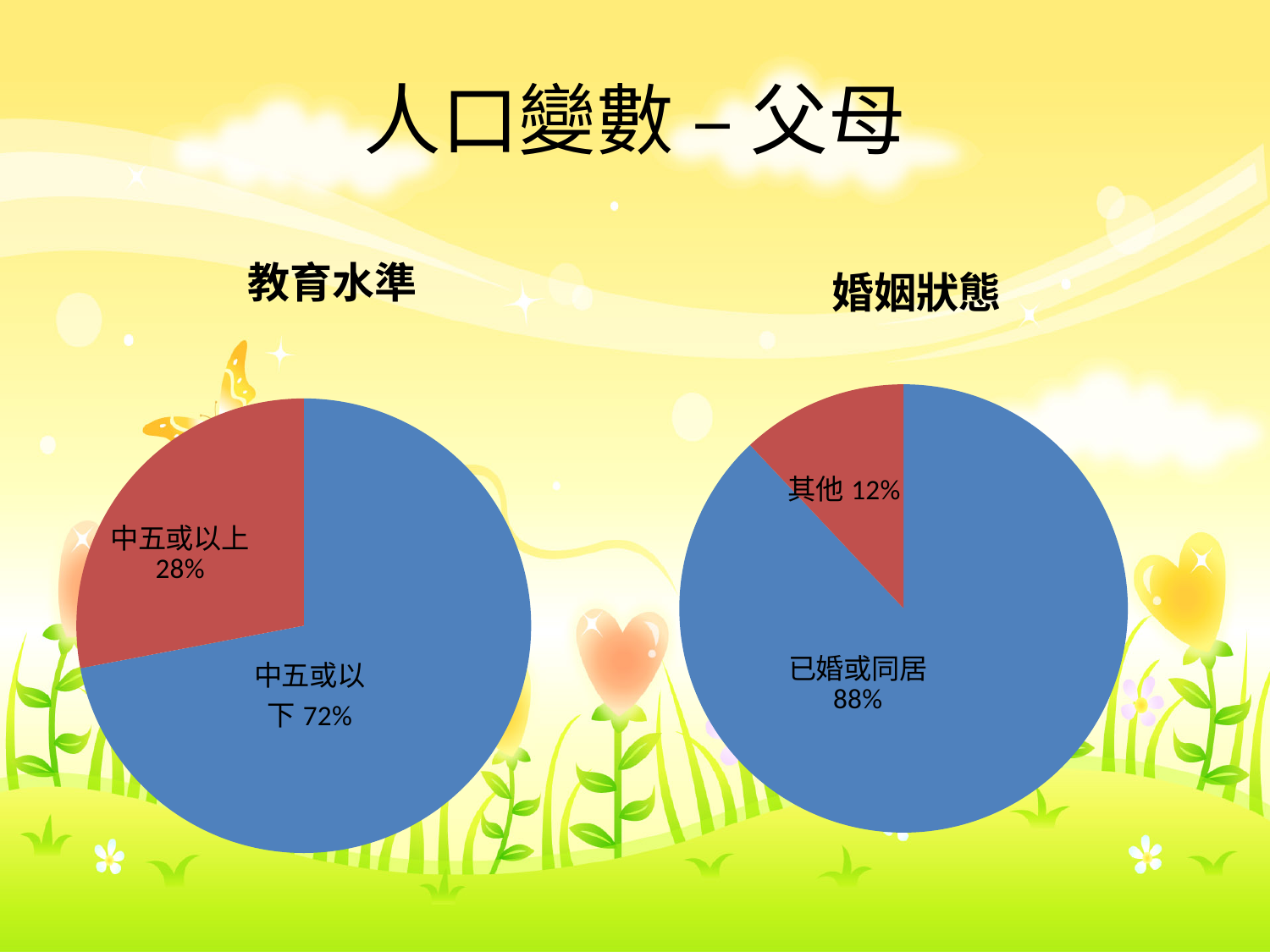
How many slices does the 婚姻狀態 chart have? 2 In the 婚姻狀態 chart, what is the difference between the 已婚或同居 and 其他 shares? 76% In the 婚姻狀態 chart, which slice is the smallest? 其他 How many charts are shown on the slide? 2 In the 教育水準 chart, what is the difference between the 中五或以下 and 中五或以上 shares? 44% In the 教育水準 chart, what share is labelled 中五或以下? 72% In the 教育水準 chart, what share is labelled 中五或以上? 28% In the 婚姻狀態 chart, what share is labelled 已婚或同居? 88% Which is larger: the 其他 share in the 婚姻狀態 chart or the 中五或以上 share in the 教育水準 chart? 中五或以上 In the 婚姻狀態 chart, what share is labelled 其他? 12% In the 教育水準 chart, which slice is the largest? 中五或以下 What kind of chart is the 教育水準 chart? Pie chart